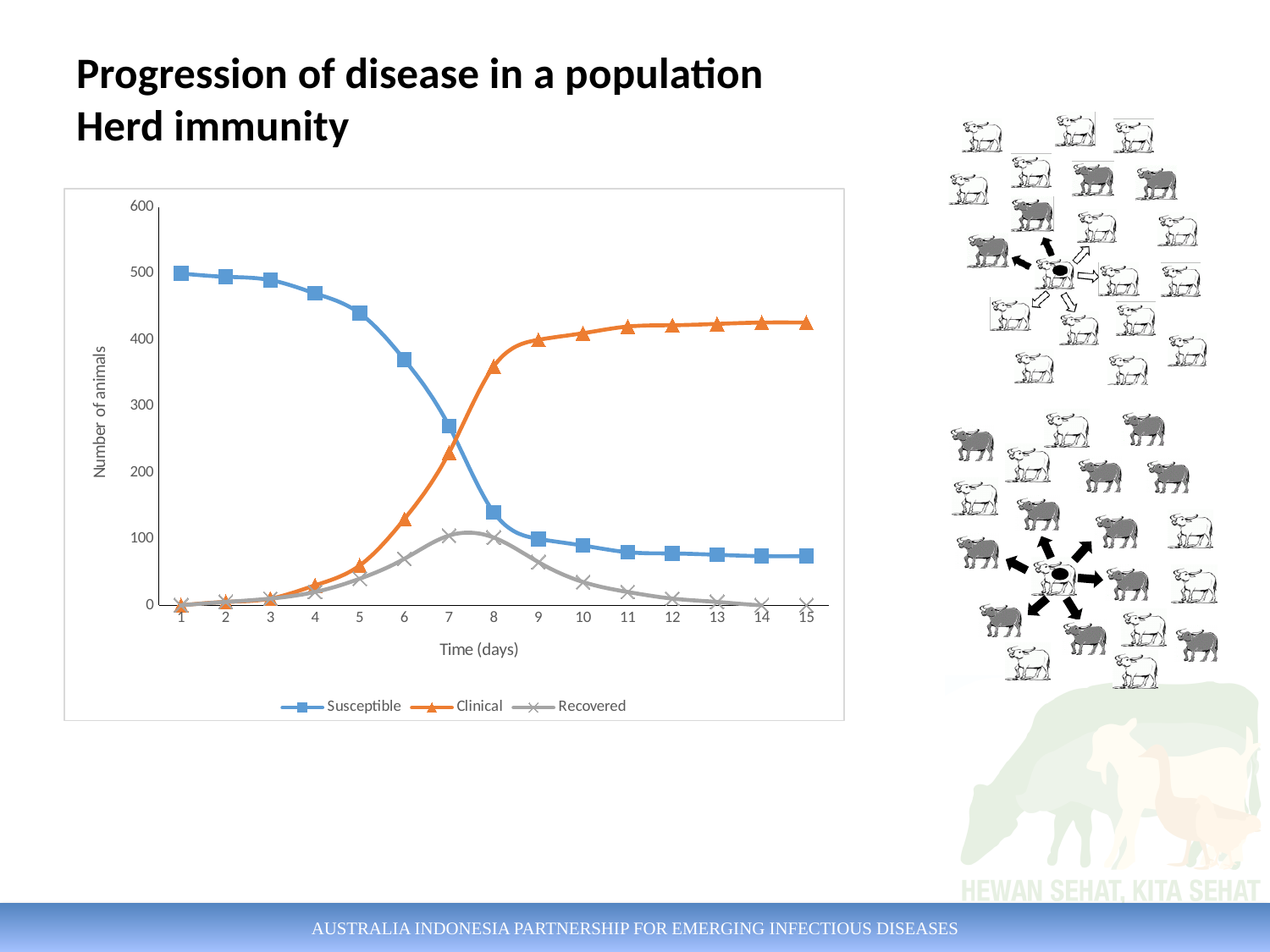
At day 5, which is larger: Susceptible or Clinical? Susceptible Does the Susceptible series rise or fall as time increases from day 1 to day 15? fall At day 10, which is larger: Clinical or Susceptible? Clinical How many time points (days) are plotted along the x axis? 15 What kind of chart is shown on the slide? line chart Is the Susceptible value at day 15 greater or less than 100? less Is the Susceptible value at day 1 greater or less than 400? greater What is the title of the x axis? Time (days) Which series has the highest value at day 15? Clinical Is the Clinical value at day 15 greater or less than 400? greater How many series does the legend list? 3